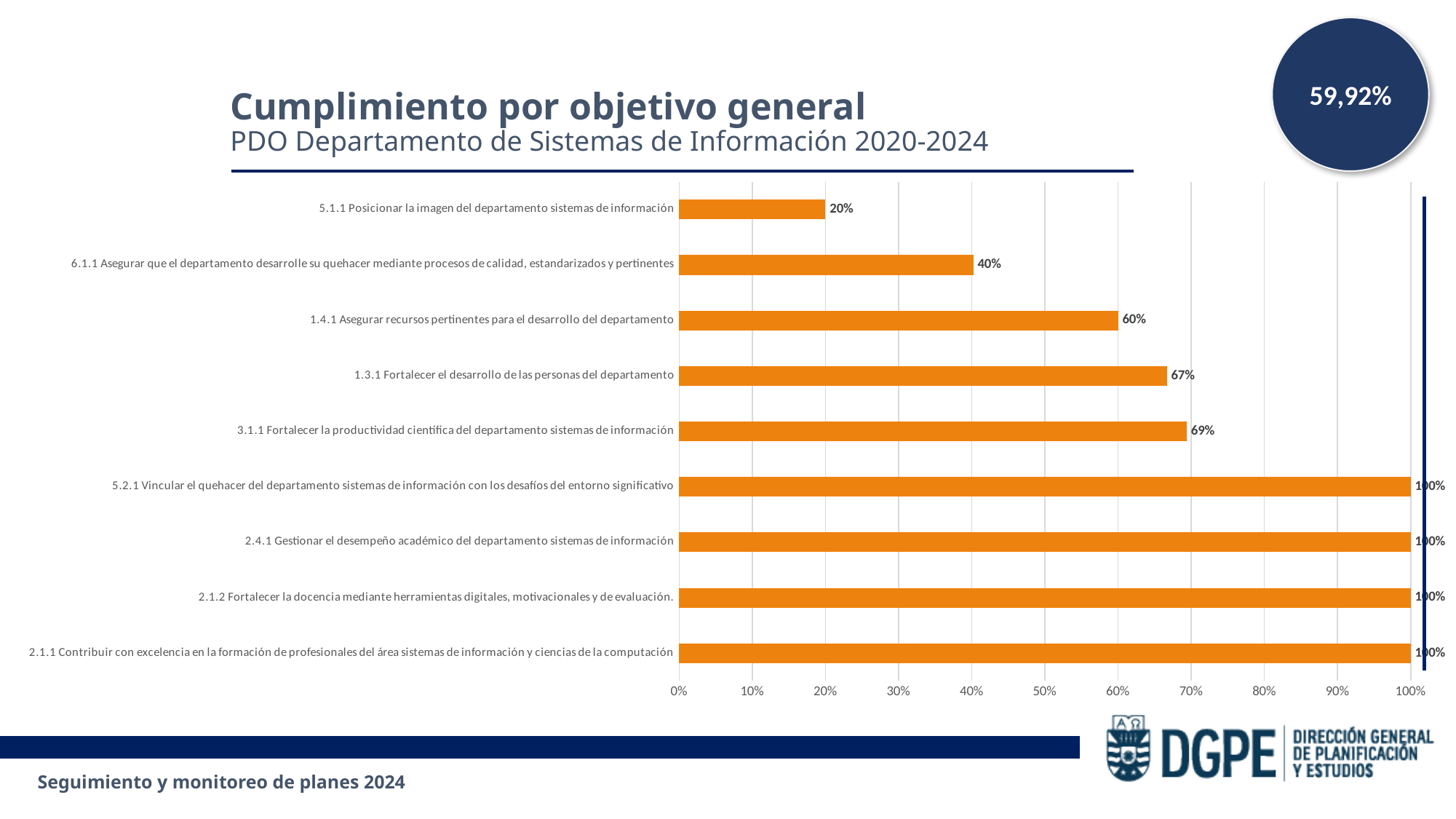
What is the value for 1.3.1 Fortalecer el desarrollo de las personas del departamento? 67% What overall percentage is shown in the circle at the top right of the slide? 59,92% What is the difference between the values for 3.1.1 Fortalecer la productividad científica and 1.3.1 Fortalecer el desarrollo de las personas del departamento? 2% How many objectives have a value of 100%? 4 What is the difference between the values for 1.4.1 Asegurar recursos pertinentes para el desarrollo del departamento and 5.1.1 Posicionar la imagen del departamento sistemas de información? 40% Which objective has the lowest value? 5.1.1 Posicionar la imagen del departamento sistemas de información Which is larger: the value for 6.1.1 Asegurar que el departamento desarrolle su quehacer mediante procesos de calidad or the value for 1.4.1 Asegurar recursos pertinentes para el desarrollo del departamento? 1.4.1 Asegurar recursos pertinentes para el desarrollo del departamento What kind of chart is shown on the slide? Bar chart What is the value for 3.1.1 Fortalecer la productividad científica del departamento sistemas de información? 69% How many objectives are plotted in the chart? 9 What is the value for 5.1.1 Posicionar la imagen del departamento sistemas de información? 20% What is the value for 6.1.1 Asegurar que el departamento desarrolle su quehacer mediante procesos de calidad, estandarizados y pertinentes? 40%